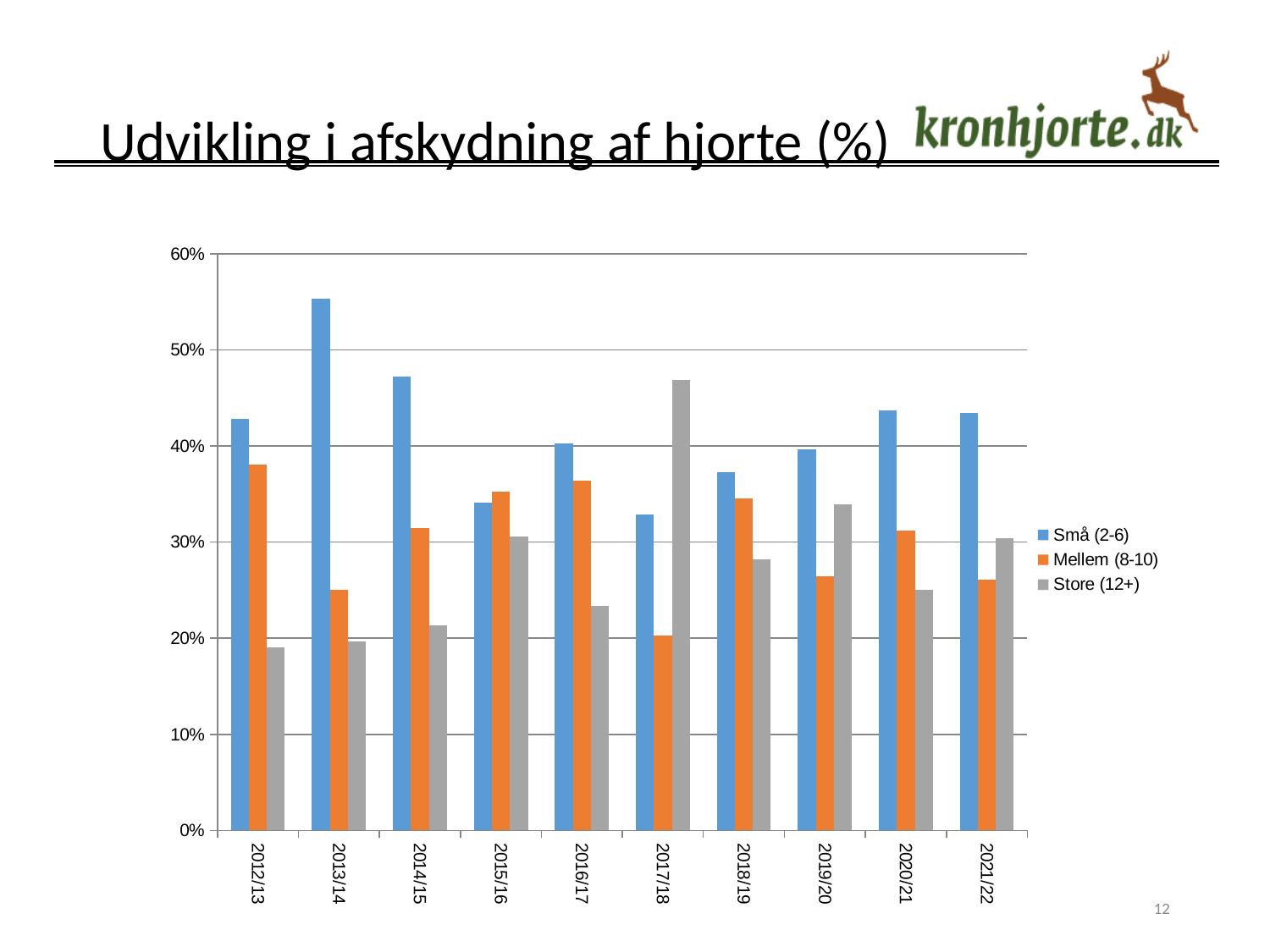
In 2019/20, which is larger: Mellem (8-10) or Store (12+)? Store (12+) What is the title of the chart on the slide? Udvikling i afskydning af hjorte (%) In 2017/18, which is larger: Små (2-6) or Store (12+)? Store (12+) Is the value for Store (12+) in 2012/13 greater or less than 20%? less How many series does the legend list? 3 In which season is the value for Små (2-6) highest? 2013/14 Is the value for Store (12+) in 2017/18 greater or less than 40%? greater Is the value for Små (2-6) in 2013/14 greater or less than 50%? greater In which season is the value for Store (12+) highest? 2017/18 What kind of chart is shown on the slide? bar chart How many seasons (categories) are shown on the x axis? 10 In which season is the value for Mellem (8-10) lowest? 2017/18